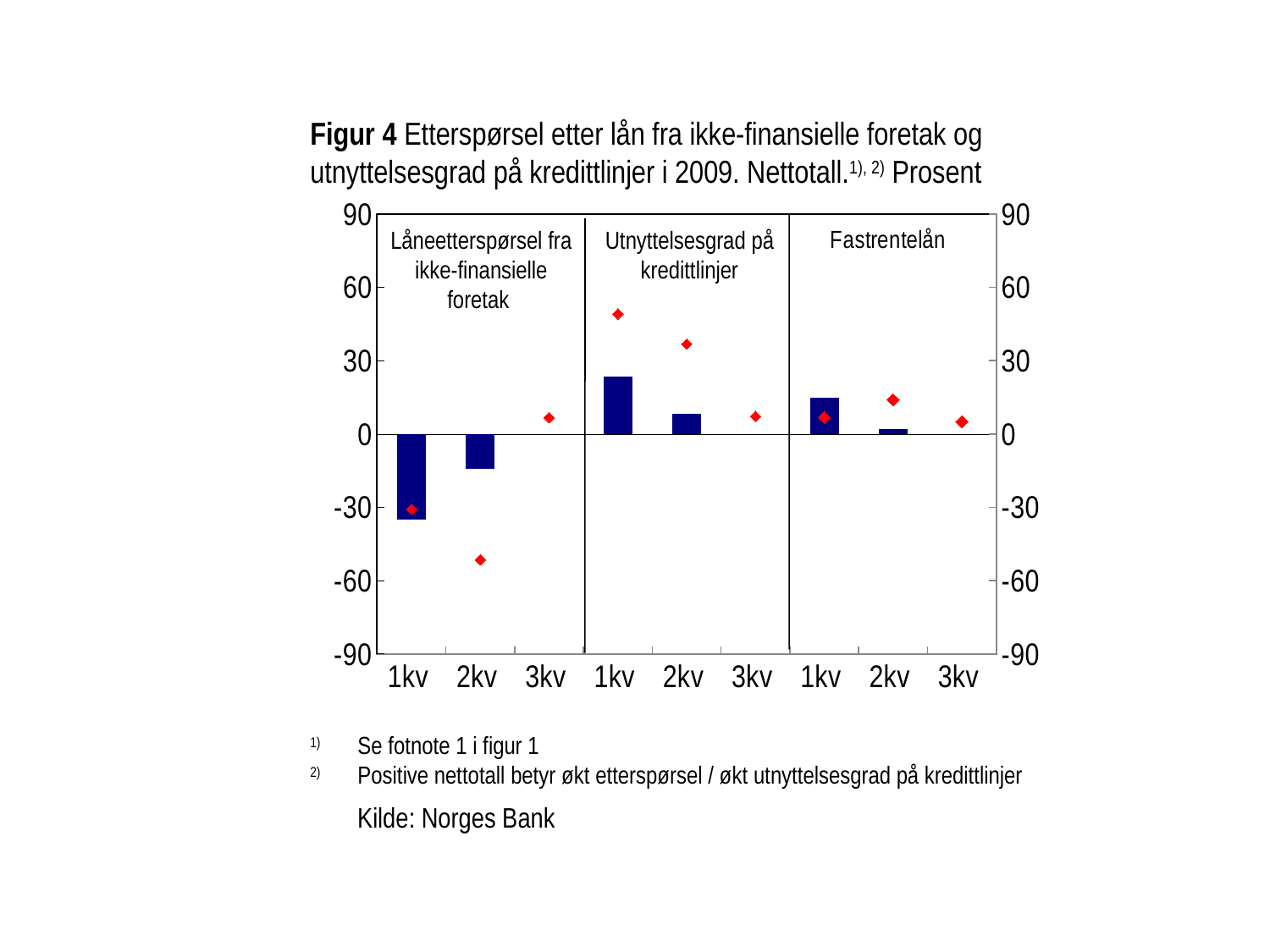
In the panel 'Låneetterspørsel fra ikke-finansielle foretak', is the red diamond for 2kv greater or less than -30? less In the panel 'Utnyttelsesgrad på kredittlinjer', do the bars rise or fall from 1kv to 3kv? fall How many quarter categories are shown along the x axis in total across the three panels? 9 In the panel 'Utnyttelsesgrad på kredittlinjer', which quarter has the highest bar? 1kv In the panel 'Utnyttelsesgrad på kredittlinjer', is the bar for 1kv greater or less than 30? less In the panel 'Låneetterspørsel fra ikke-finansielle foretak', is the bar for 1kv greater or less than -30? less What kind of chart is shown on the slide? combination chart with bars and diamond markers In the panel 'Utnyttelsesgrad på kredittlinjer', which is larger for 1kv: the bar or the red diamond? the red diamond In the panel 'Låneetterspørsel fra ikke-finansielle foretak', which quarter has the lowest bar? 1kv How many panels (sections) does the chart have? 3